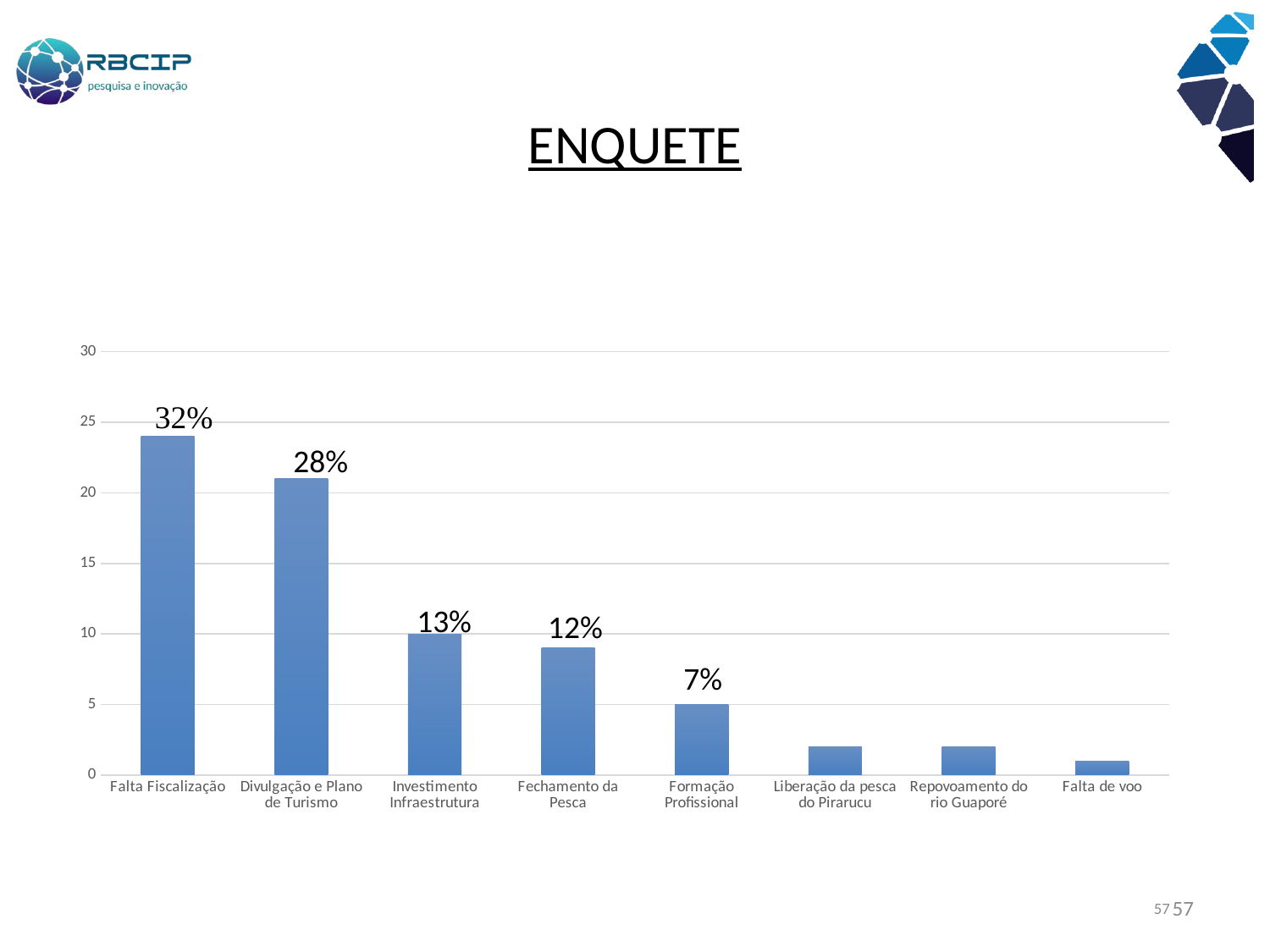
Which has the larger percentage label, Investimento Infraestrutura or Fechamento da Pesca? Investimento Infraestrutura What is the difference between the percentage labels for Falta Fiscalização and Divulgação e Plano de Turismo? 4% Which category has the lowest bar in the chart? Falta de voo How many categories are shown on the x axis of the chart? 8 What percentage label is shown above the bar for Falta Fiscalização? 32% Do the bar values rise or fall from left to right along the x axis? fall Which category has the highest bar in the chart? Falta Fiscalização What kind of chart is shown on the slide? bar chart What percentage label is shown above the bar for Divulgação e Plano de Turismo? 28% What is the title of the slide containing the chart? ENQUETE Is the value for Falta Fiscalização greater or less than 20? greater What percentage label is shown above the bar for Formação Profissional? 7%